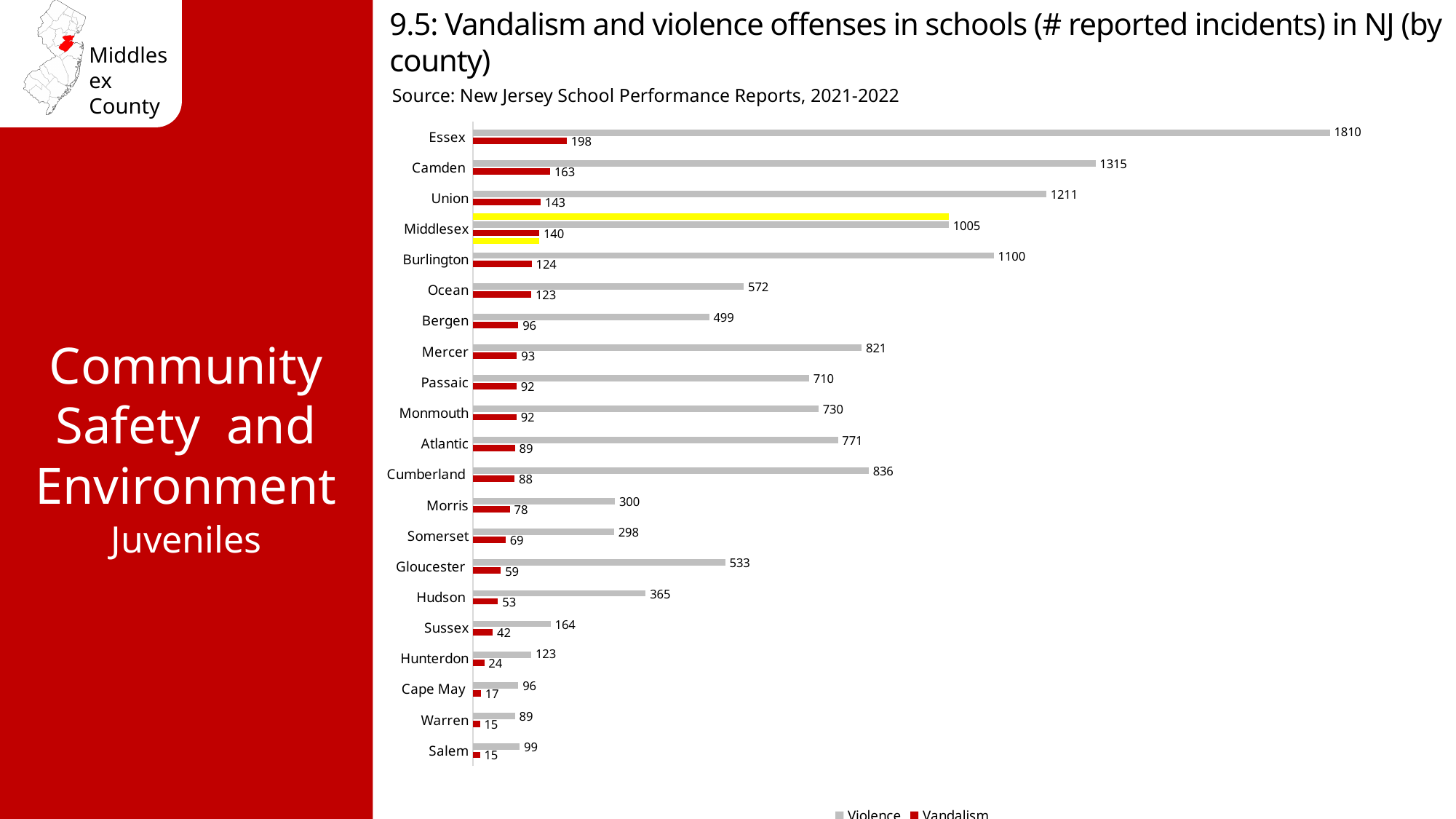
What is the combined total of violence and vandalism incidents for Middlesex County? 1145 What kind of chart is shown on the slide? Bar chart Which county has more reported violence incidents, Ocean or Gloucester? Ocean Which county has the highest number of reported violence incidents? Essex Which county has the highest number of reported vandalism incidents? Essex Which series is shown in red in the chart? Vandalism Which county has the lowest number of reported violence incidents? Warren How many counties are shown in the chart? 21 What is the number of reported violence incidents for Middlesex County? 1005 What is the difference between the violence incidents in Essex and Camden? 495 What is the number of reported vandalism incidents for Camden County? 163 How many series does the legend list? 2